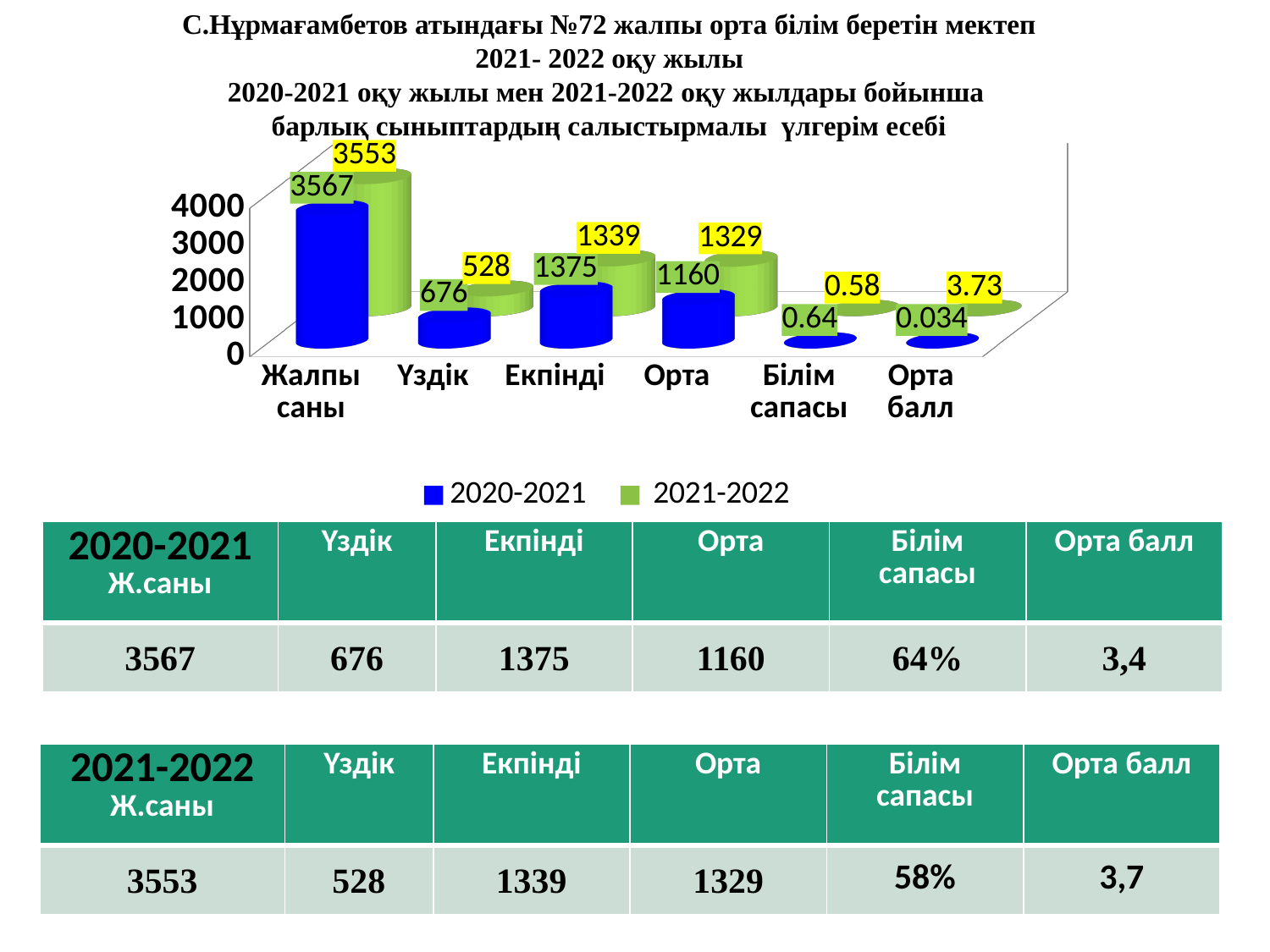
Which series is shown in green in the chart? 2021-2022 What is the value for Білім сапасы in the 2021-2022 series? 0.58 How many series does the chart legend list? 2 What is the difference between the 2020-2021 and 2021-2022 values for Үздік? 148 What is the value for Жалпы саны in the 2020-2021 series? 3567 What is the value for Үздік in the 2021-2022 series? 528 What is the value for Жалпы саны in the 2021-2022 series? 3553 What kind of chart is shown on the slide? bar chart Which category has the highest value in the 2020-2021 series? Жалпы саны What is the value for Орта in the 2020-2021 series? 1160 How many categories are shown on the x axis of the chart? 6 For Орта, which series has the larger value, 2020-2021 or 2021-2022? 2021-2022